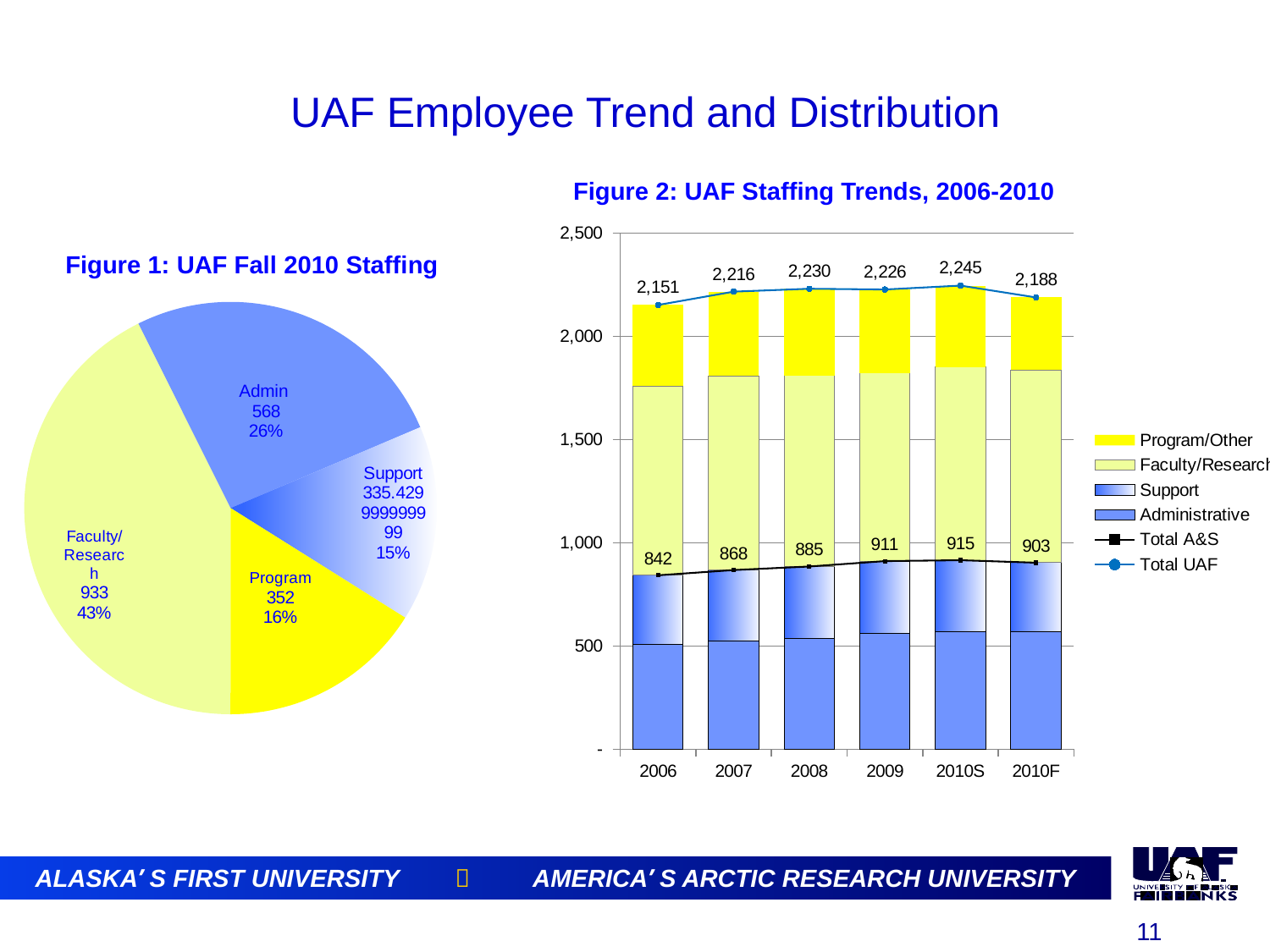
In Figure 1: UAF Fall 2010 Staffing, what kind of chart is shown? Pie chart In Figure 1: UAF Fall 2010 Staffing, which category has the largest slice? Faculty/Research In Figure 2: UAF Staffing Trends, 2006-2010, is the Total UAF value for 2010F greater or less than 2,000? greater In Figure 2: UAF Staffing Trends, 2006-2010, which year has the highest Total UAF value? 2010S In Figure 1: UAF Fall 2010 Staffing, how many slices does the pie have? 4 In Figure 1: UAF Fall 2010 Staffing, what share of the pie does Admin represent? 26% In Figure 2: UAF Staffing Trends, 2006-2010, how many series does the legend list? 6 In Figure 2: UAF Staffing Trends, 2006-2010, what is the Total UAF value for 2008? 2,230 In Figure 1: UAF Fall 2010 Staffing, how many employees are in the Faculty/Research category? 933 In Figure 2: UAF Staffing Trends, 2006-2010, what is the Total A&S value for 2009? 911 In Figure 2: UAF Staffing Trends, 2006-2010, which year has the lowest Total A&S value? 2006 In Figure 1: UAF Fall 2010 Staffing, what is the difference between the Admin count and the Program count? 216